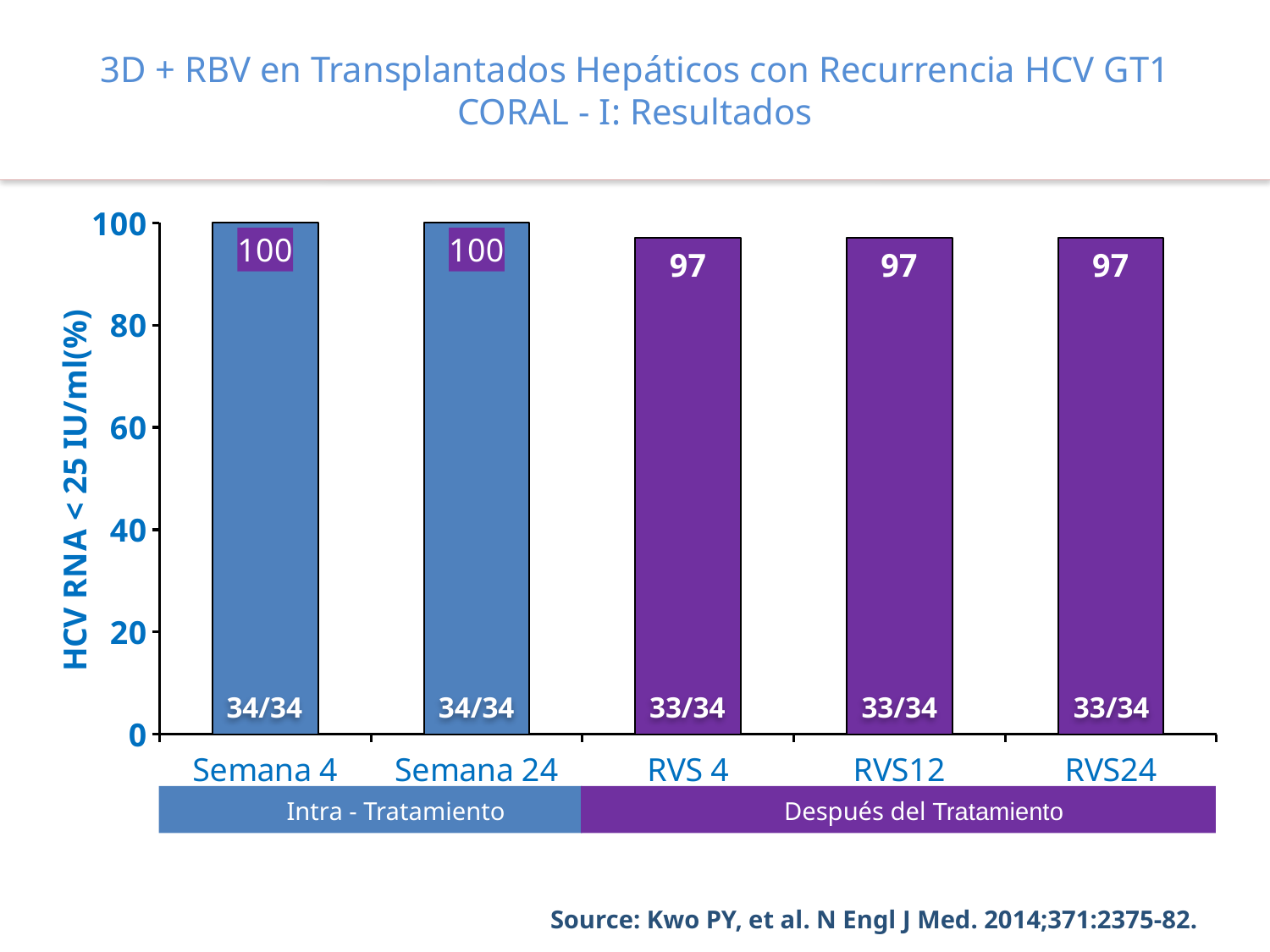
Is the value for RVS12 greater or less than 80? greater What is the value for RVS24? 97 What fraction of patients is shown inside the Semana 24 bar? 34/34 Which phase label is shown under the purple bars? Después del Tratamiento What is the label of the y axis? HCV RNA < 25 IU/ml(%) What fraction of patients is shown inside the RVS 4 bar? 33/34 What is the difference between the value for Semana 24 and the value for RVS 4? 3 How many categories are shown on the x axis? 5 What is the value for Semana 4? 100 What kind of chart is shown on the slide? bar chart Which is larger, the value for Semana 4 or the value for RVS24? Semana 4 What is the value for RVS12? 97